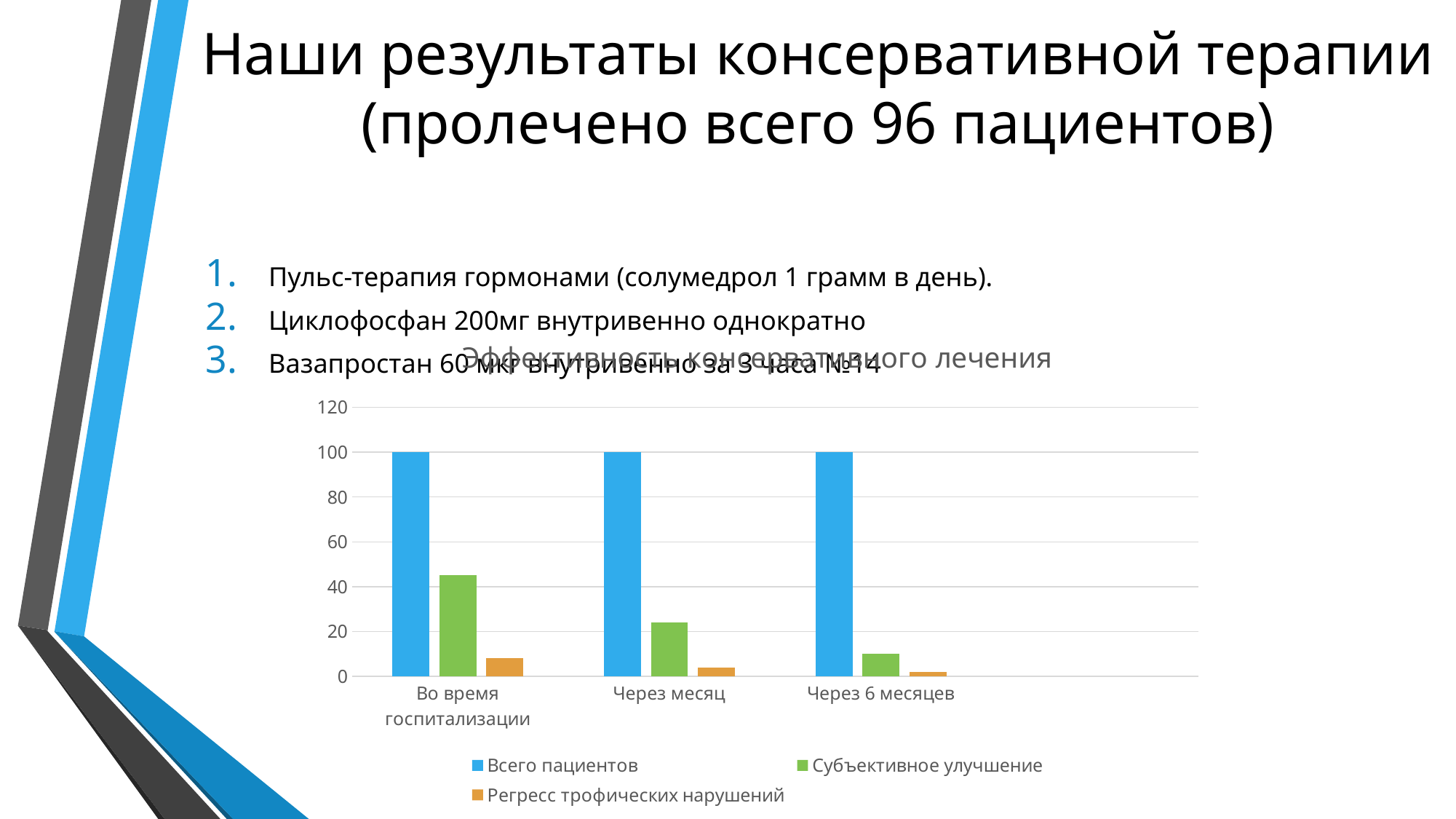
What is the value of "Всего пациентов" for "Через 6 месяцев"? 100 What kind of chart is shown on the slide? bar chart How many categories are shown along the x axis of the chart? 3 Which is larger for "Через месяц": "Субъективное улучшение" or "Регресс трофических нарушений"? Субъективное улучшение Is the value of "Субъективное улучшение" for "Через месяц" greater or less than 40? less How many series does the chart legend list? 3 In which category is "Субъективное улучшение" highest? Во время госпитализации Is the value of "Субъективное улучшение" for "Через 6 месяцев" greater or less than 20? less Is the value of "Субъективное улучшение" for "Во время госпитализации" greater or less than 40? greater What is the value of "Всего пациентов" for "Во время госпитализации"? 100 Do the values of "Субъективное улучшение" rise or fall from "Во время госпитализации" to "Через 6 месяцев"? fall